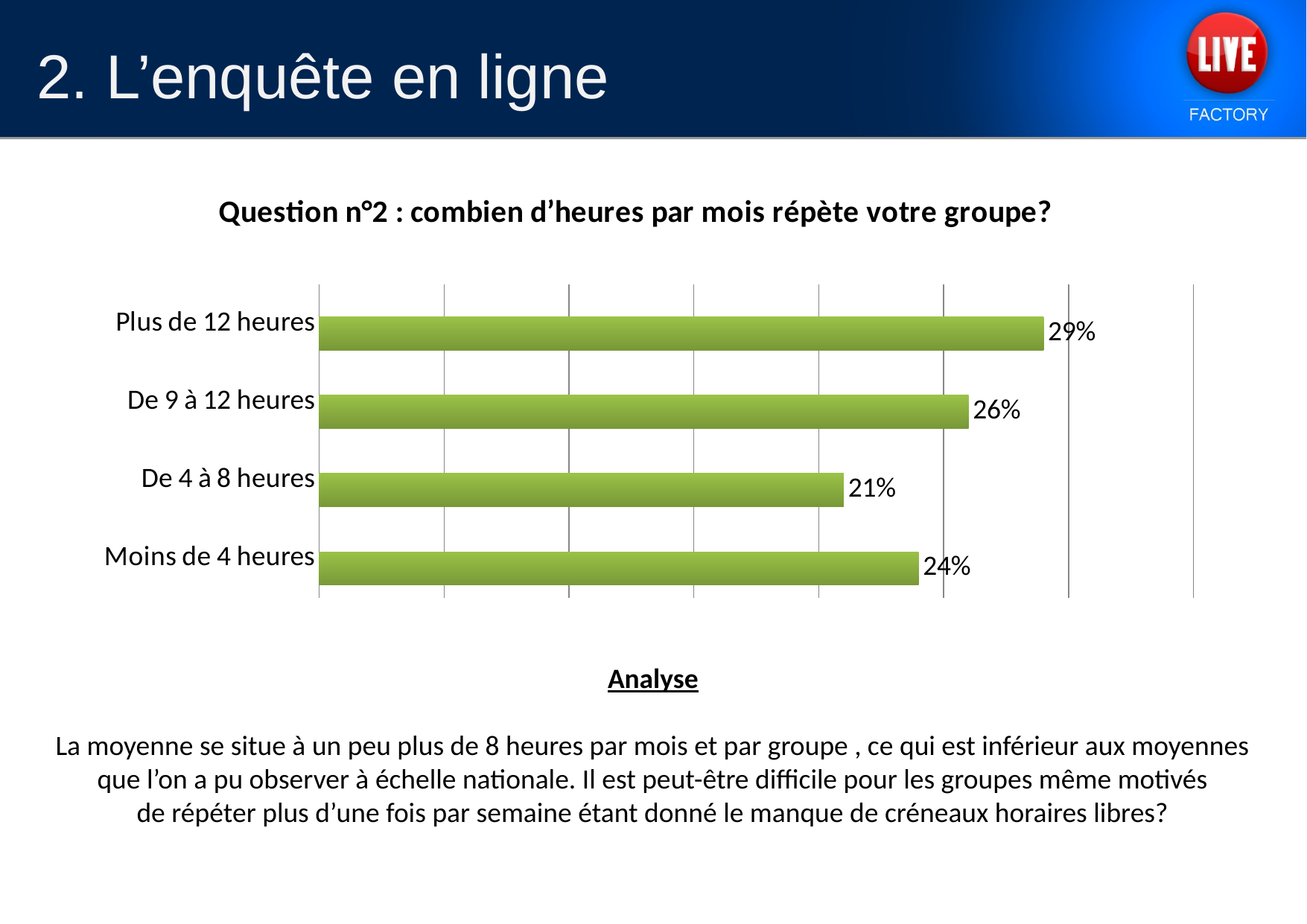
What is the title of the chart? Question n°2 : combien d'heures par mois répète votre groupe? What is the value for 'De 4 à 8 heures'? 21% What is the difference between the values for 'De 9 à 12 heures' and 'Moins de 4 heures'? 2% What is the difference between the values for 'Plus de 12 heures' and 'De 4 à 8 heures'? 8% What is the value for 'De 9 à 12 heures'? 26% Which is larger: the value for 'Moins de 4 heures' or the value for 'De 4 à 8 heures'? Moins de 4 heures Which category has the highest value? Plus de 12 heures What kind of chart is shown on the slide? Bar chart How many categories are shown in the chart? 4 Which category has the lowest value? De 4 à 8 heures What is the value for 'Moins de 4 heures'? 24% What percentage of groups rehearse more than 12 hours per month (Plus de 12 heures)? 29%